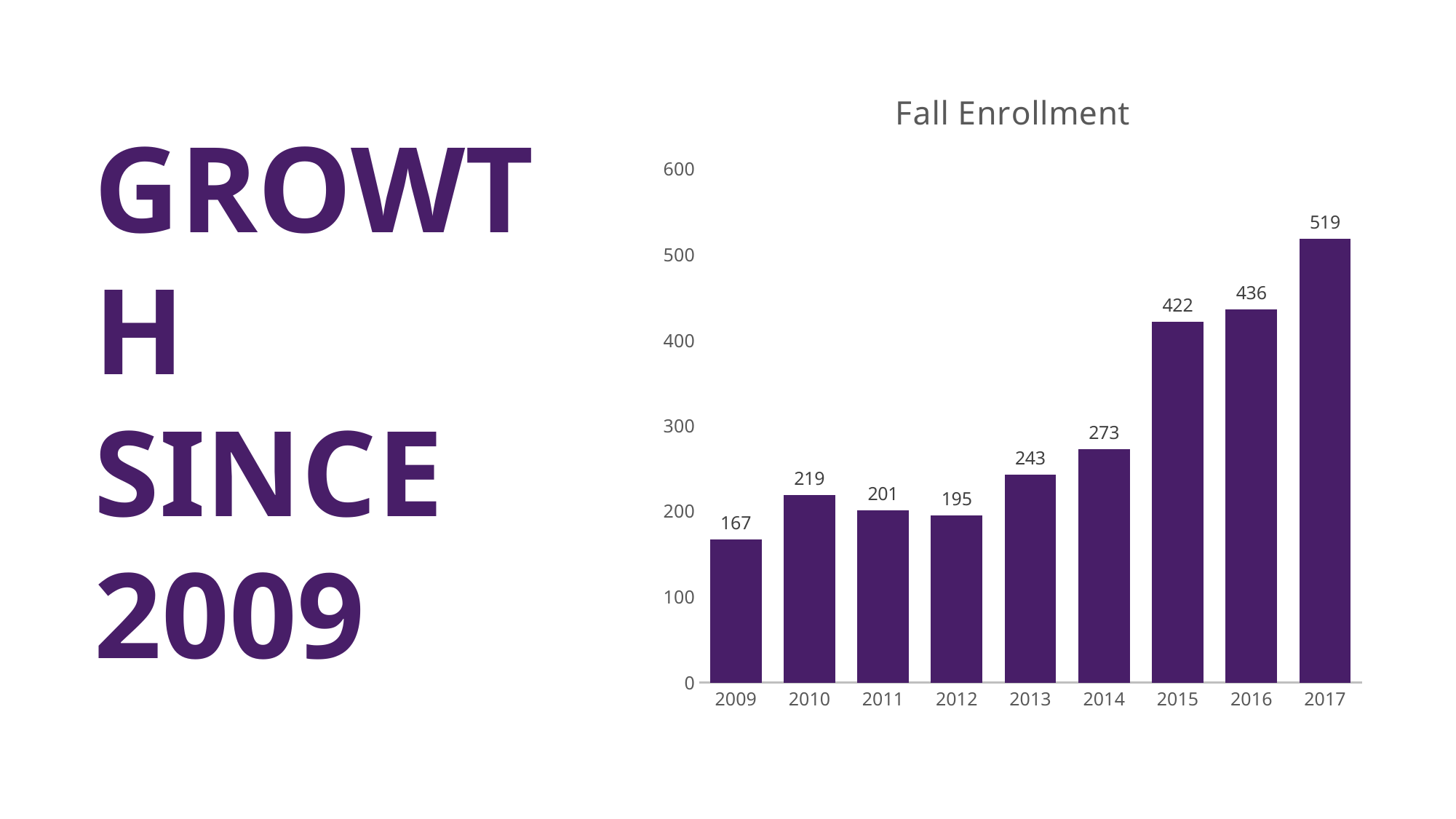
Which year has a higher Fall Enrollment, 2011 or 2012? 2011 What kind of chart is used to show Fall Enrollment? Bar chart What is the Fall Enrollment value for 2013? 243 What is the difference in Fall Enrollment between 2017 and 2009? 352 Which year has the lowest Fall Enrollment? 2009 What is the Fall Enrollment value for 2016? 436 Which year has the highest Fall Enrollment? 2017 What is the difference in Fall Enrollment between 2015 and 2014? 149 Is the Fall Enrollment value for 2015 greater or less than 400? greater How many years are shown on the Fall Enrollment chart? 9 Does Fall Enrollment rise or fall from 2014 to 2017? Rise What is the title of the chart on the slide? Fall Enrollment